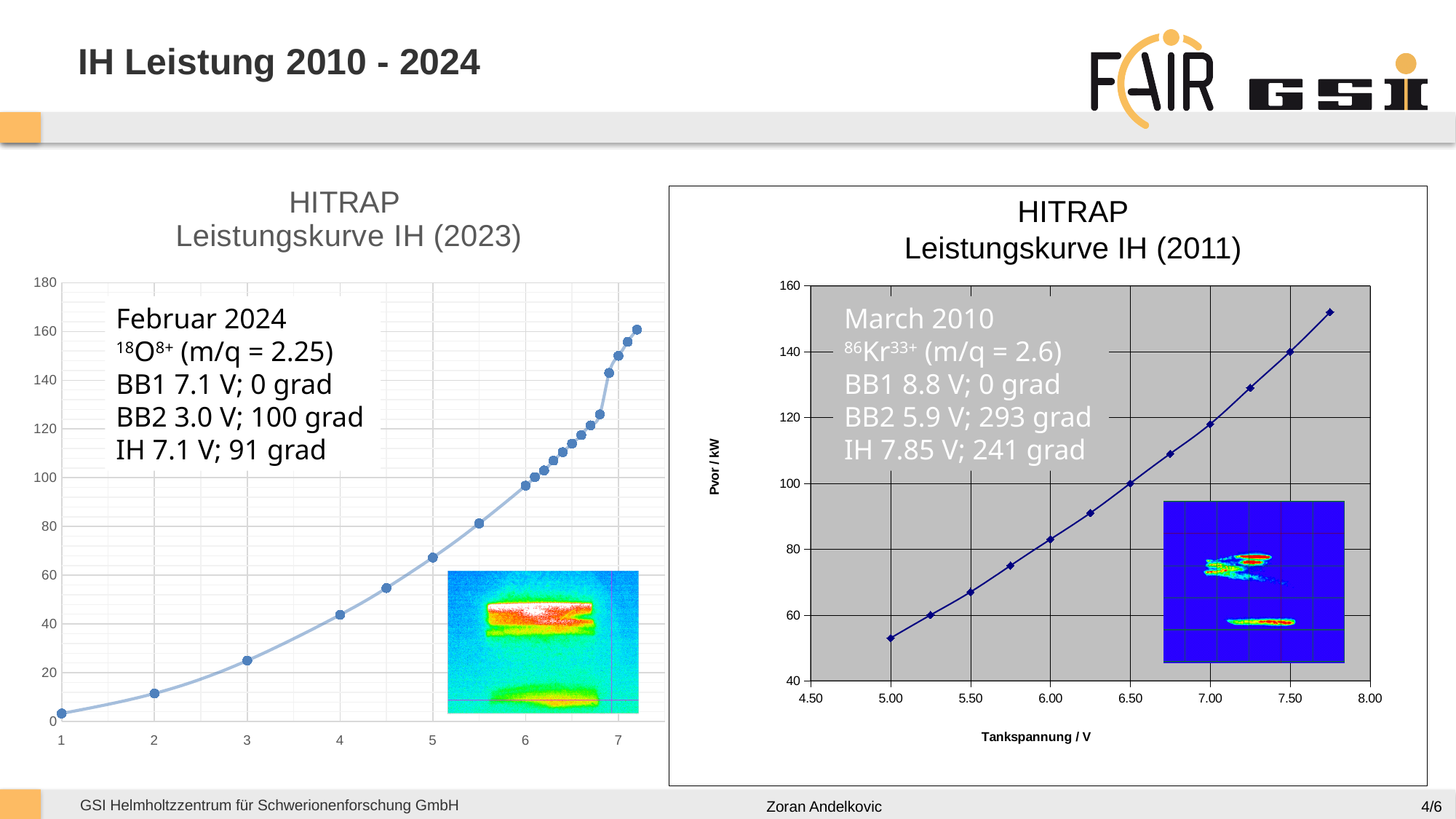
On the 'HITRAP Leistungskurve IH (2011)' chart, is the value at 7.75 V greater or less than 140? greater On the chart titled 'HITRAP Leistungskurve IH (2011)', what is the label of the y axis? Pvor / kW On the 'HITRAP Leistungskurve IH (2023)' chart, is the value at x = 1 greater or less than 20? less On the 'HITRAP Leistungskurve IH (2011)' chart, is the value at 5.00 V greater or less than 60? less On the chart titled 'HITRAP Leistungskurve IH (2011)', what is the label of the x axis? Tankspannung / V On the 'HITRAP Leistungskurve IH (2023)' chart, do the values rise or fall along the x axis? rise How many data points are plotted on the 'HITRAP Leistungskurve IH (2011)' chart? 12 What kind of chart is the 'HITRAP Leistungskurve IH (2023)' chart on the left? line chart On the 'HITRAP Leistungskurve IH (2011)' chart, do the values rise or fall as Tankspannung increases? rise